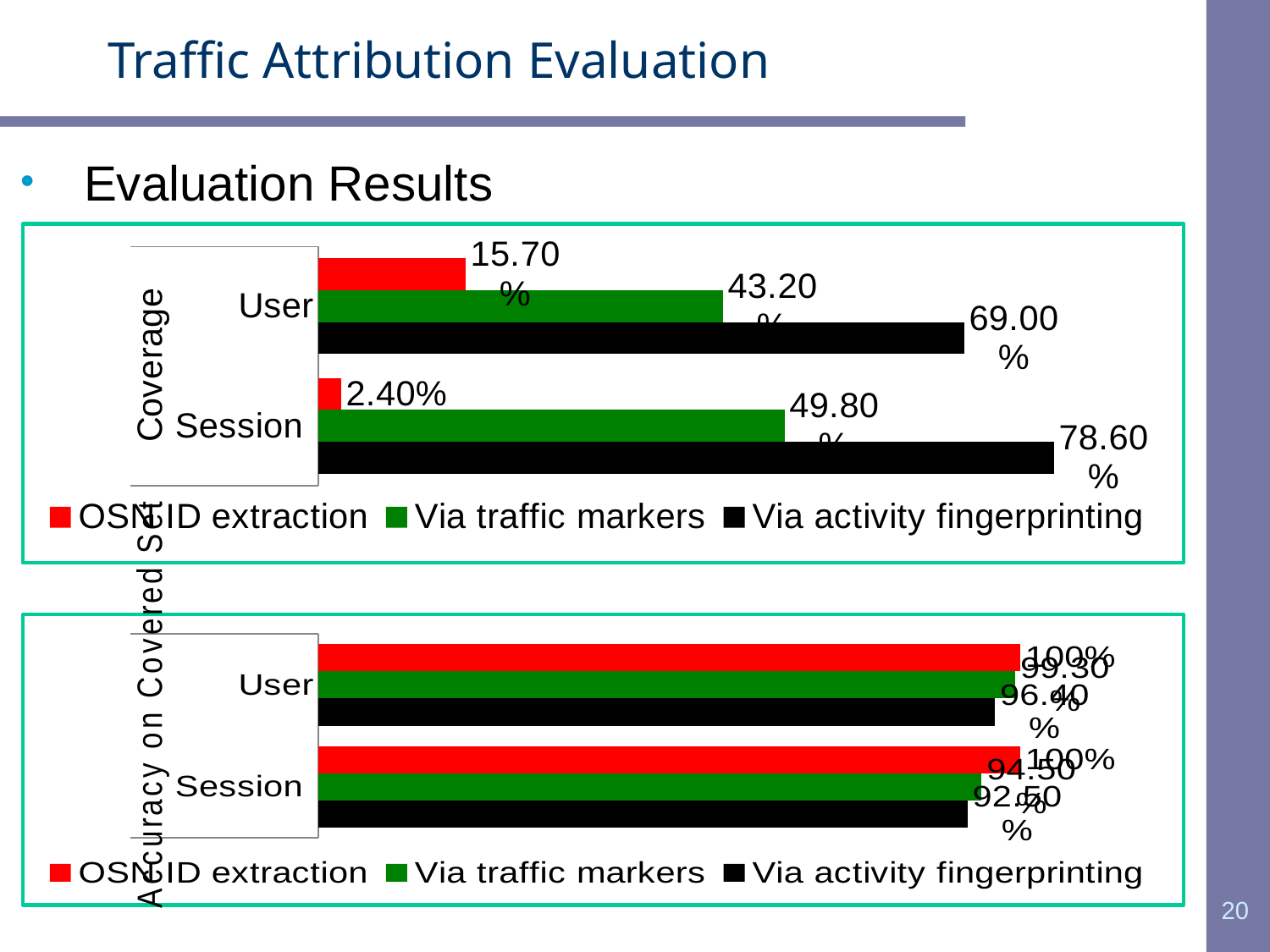
In the top chart (Coverage), what is the value for Via traffic markers for Session? 49.80% In the bottom chart (Accuracy on Covered Set), what is the value for Via activity fingerprinting for User? 96.40% In the bottom chart (Accuracy on Covered Set), what is the difference between Via traffic markers and Via activity fingerprinting for Session? 2.00% What kind of chart is the bottom chart (Accuracy on Covered Set)? Bar chart In the top chart (Coverage), what is the value for OSN ID extraction for User? 15.70% In the top chart (Coverage), what is the difference between Via activity fingerprinting and Via traffic markers for User? 25.80% In the top chart (Coverage), which series has the highest value for User? Via activity fingerprinting In the top chart (Coverage), what is the value for Via activity fingerprinting for Session? 78.60% In the top chart (Coverage), which series has the lowest value for Session? OSN ID extraction In the top chart (Coverage), is the OSN ID extraction value larger for User or for Session? User In the bottom chart (Accuracy on Covered Set), what is the value for OSN ID extraction for Session? 100% How many series does the legend of the top chart (Coverage) list? 3